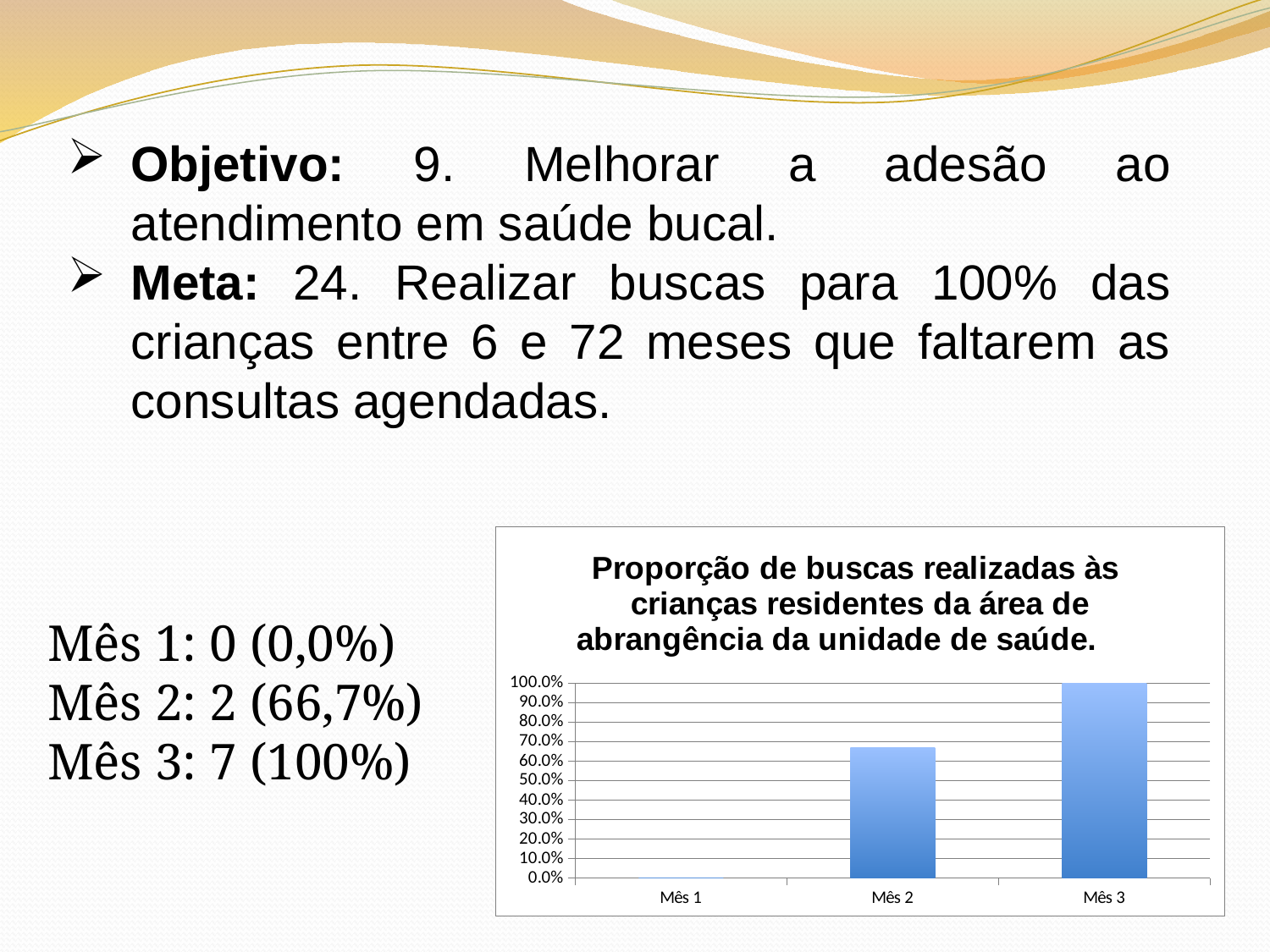
Which month has the highest value in the chart? Mês 3 What is the difference between the values for Mês 3 and Mês 1? 100.0% Is the value for Mês 2 greater or less than 70.0%? less What is the value for Mês 1 in the chart? 0.0% What kind of chart is shown on the slide? bar chart Which is larger, the value for Mês 2 or the value for Mês 3? Mês 3 Is the value for Mês 2 greater or less than 60.0%? greater Do the values rise or fall from Mês 1 to Mês 3? rise How many categories are shown on the x axis of the chart? 3 What is the title of the chart? Proporção de buscas realizadas às crianças residentes da área de abrangência da unidade de saúde. What is the value for Mês 3 in the chart? 100.0% Which month has the lowest value in the chart? Mês 1